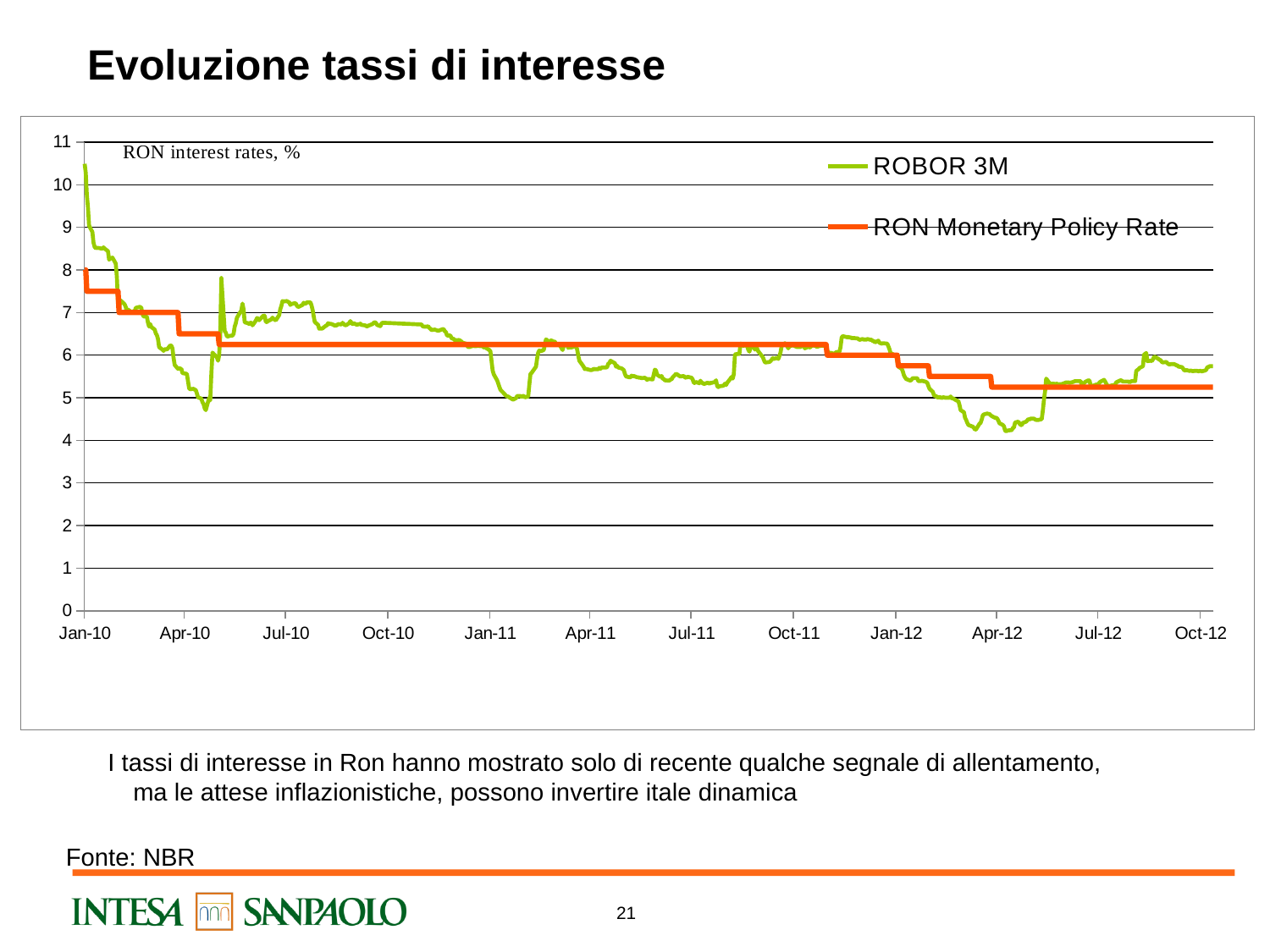
Which two series are listed in the chart legend? ROBOR 3M and RON Monetary Policy Rate What is the label printed inside the chart area describing the plotted data? RON interest rates, % At Apr-12, which series has the higher value, ROBOR 3M or RON Monetary Policy Rate? RON Monetary Policy Rate Does the RON Monetary Policy Rate rise or fall from Jan-10 to Oct-12? fall Is the value of the RON Monetary Policy Rate at Oct-12 greater or less than 6? less Is the value of ROBOR 3M at Jan-10 greater or less than 9? greater How many series does the legend list? 2 How many date labels are shown on the x axis? 12 At Jan-10, which series has the higher value, ROBOR 3M or RON Monetary Policy Rate? ROBOR 3M Is the value of the RON Monetary Policy Rate at Jul-11 greater or less than 6? greater What kind of chart is shown on the slide? line chart